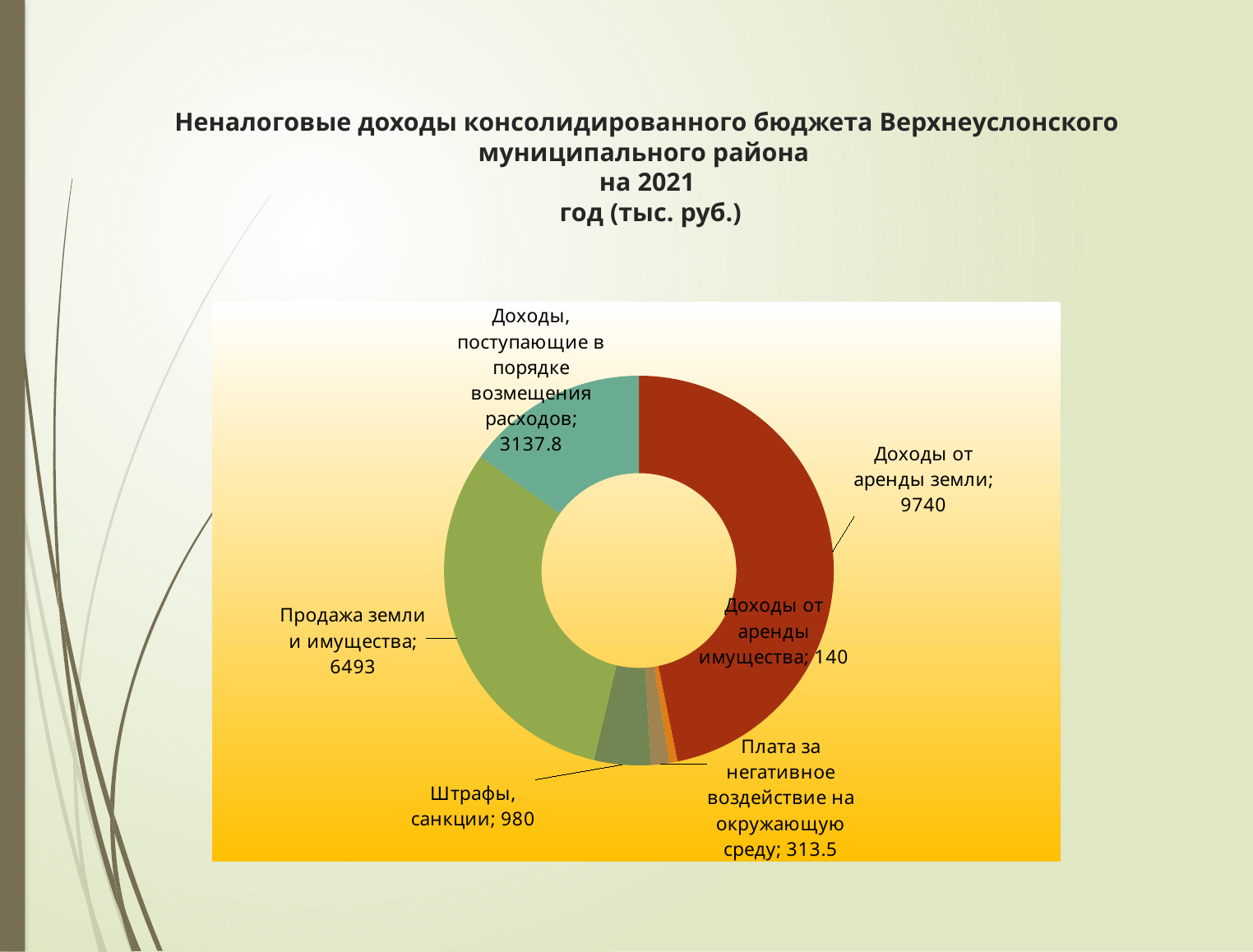
What is the value for Доходы, поступающие в порядке возмещения расходов? 3137.8 What is the difference between Доходы от аренды земли and Продажа земли и имущества? 3247 How many categories are shown in the chart? 6 What is the value for Доходы от аренды земли? 9740 What is the value for Штрафы, санкции? 980 Which is larger: Штрафы, санкции or Плата за негативное воздействие на окружающую среду? Штрафы, санкции What kind of chart is shown on the slide? Doughnut (pie) chart What is the value for Продажа земли и имущества? 6493 What is the total of all the values shown in the chart? 20804.3 Which category has the smallest value? Доходы от аренды имущества Which category has the largest value? Доходы от аренды земли What is the value for Плата за негативное воздействие на окружающую среду? 313.5